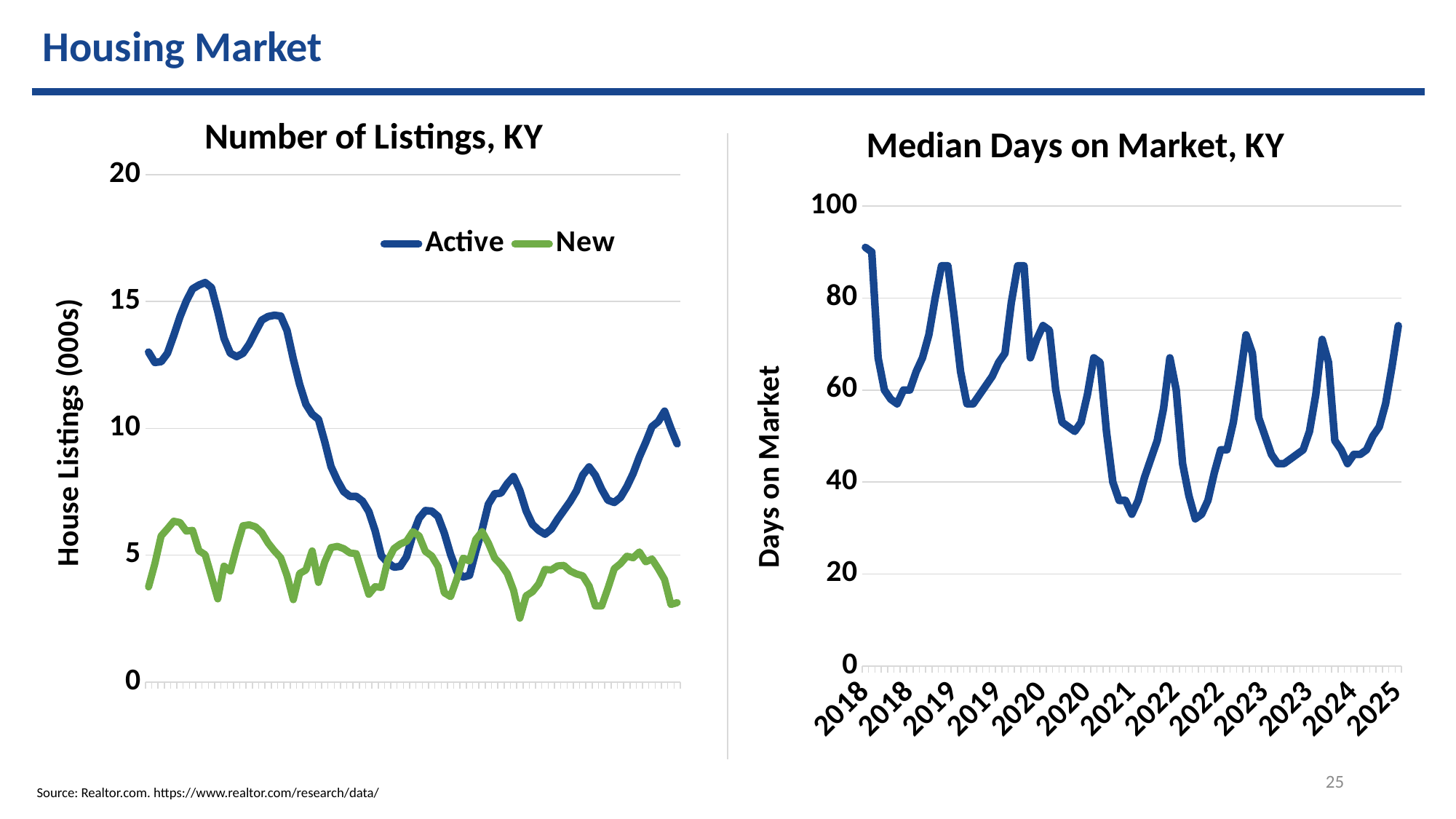
What kind of chart is the "Number of Listings, KY" chart? line chart In the "Number of Listings, KY" chart, which series is drawn in green? New In the "Median Days on Market, KY" chart, is the value at the start of 2018 greater or less than 80? greater What kind of chart is the "Median Days on Market, KY" chart? line chart In the "Median Days on Market, KY" chart, is the value at 2025 greater or less than 60? greater What is the y-axis label of the "Median Days on Market, KY" chart? Days on Market In the "Number of Listings, KY" chart, is the highest value of the Active series greater or less than 15? greater How many series does the legend of the "Number of Listings, KY" chart list? 2 In the "Median Days on Market, KY" chart, is the value at 2025 higher or lower than the value at the start of 2018? lower In the "Number of Listings, KY" chart, at the leftmost point, which series is larger, Active or New? Active